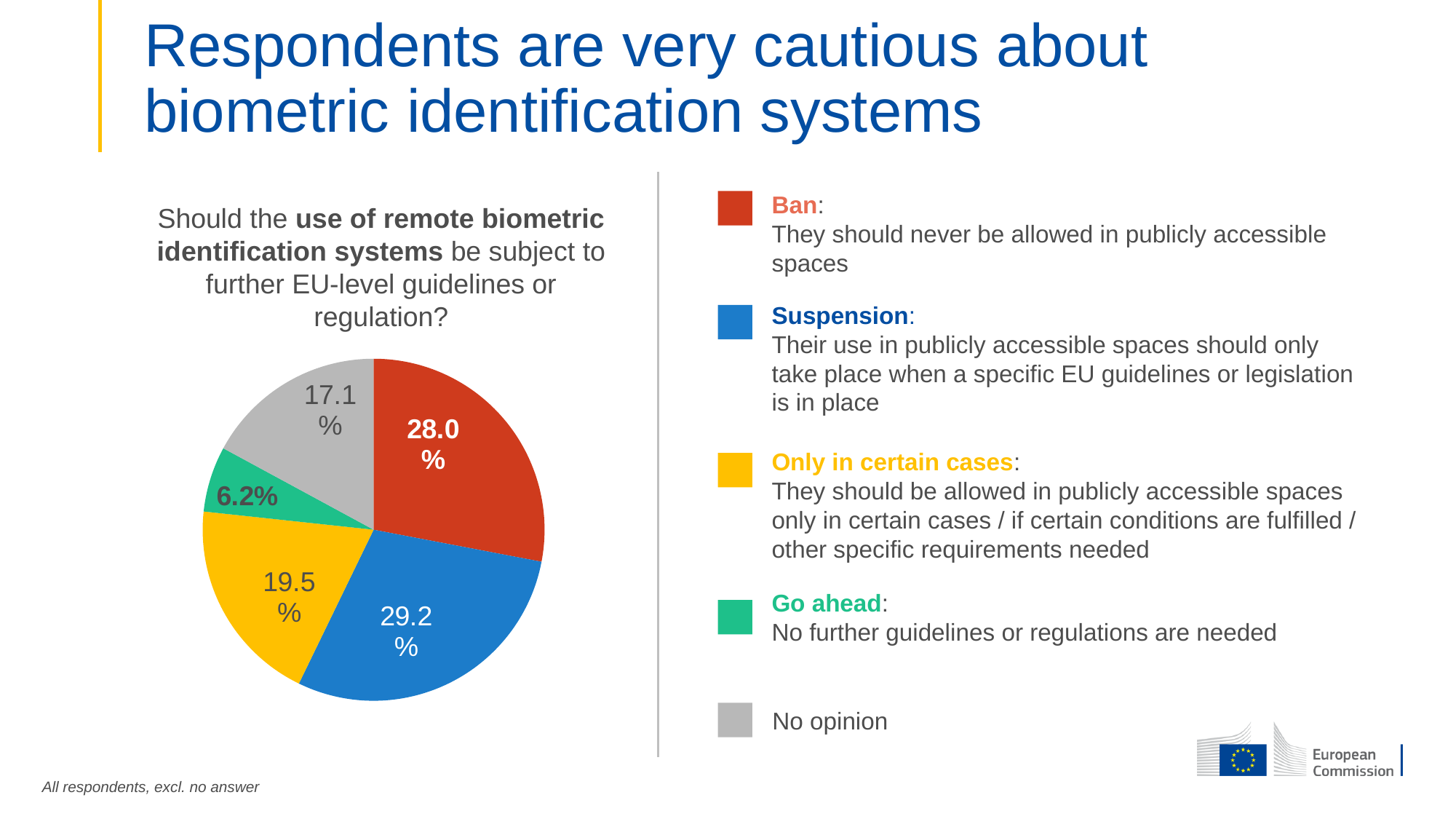
What share of respondents chose 'Only in certain cases'? 19.5% What is the difference in percentage points between 'Ban' and 'Only in certain cases'? 8.5 What share of respondents had 'No opinion'? 17.1% What type of chart is shown on the slide? pie chart Which response option has the smallest share of the pie? Go ahead Which colour represents 'Only in certain cases' in the pie chart? yellow How many slices does the pie chart have? 5 What share of respondents chose 'Suspension'? 29.2% Which is larger, the share for 'No opinion' or the share for 'Go ahead'? No opinion What share of respondents chose 'Go ahead'? 6.2% Which response option has the largest share of the pie? Suspension What share of respondents chose 'Ban'? 28.0%